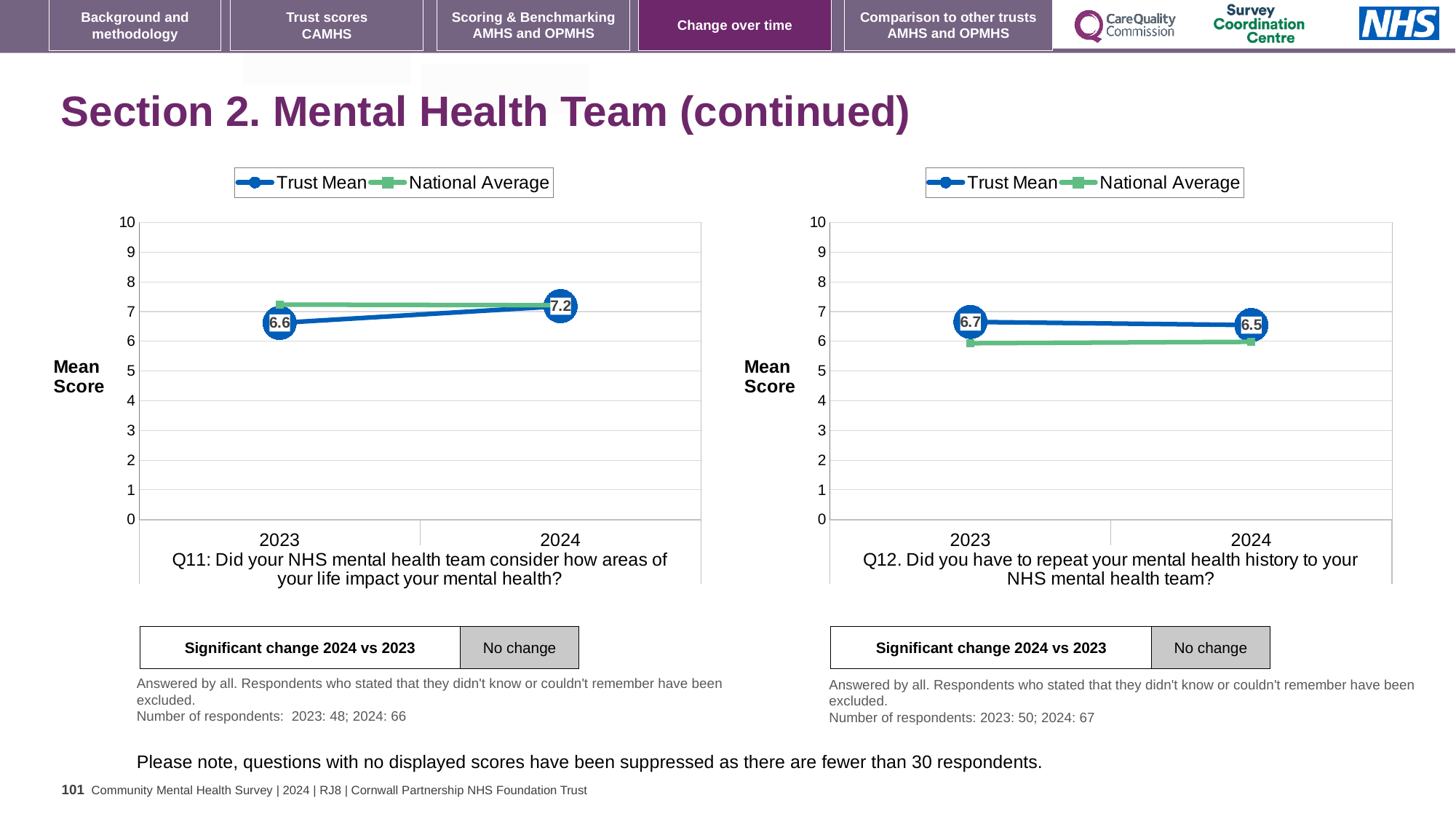
In the Q12 chart, which is larger in 2024, the Trust Mean or the National Average? Trust Mean In the Q11 chart, what is the Trust Mean score for 2023? 6.6 How many series does the legend of the Q11 chart list? 2 In the Q11 chart, what is the Trust Mean score for 2024? 7.2 In the Q11 chart, by how much did the Trust Mean change from 2023 to 2024? 0.6 In the Q12 chart, does the Trust Mean rise or fall from 2023 to 2024? fall In the Q12 chart, what is the difference between the Trust Mean for 2023 and 2024? 0.2 In the Q12 chart, is the National Average for 2023 greater or less than 7? less In the Q12 chart, what is the Trust Mean score for 2023? 6.7 In the Q11 chart, does the Trust Mean rise or fall from 2023 to 2024? rise What type of chart is used for Q12? line chart In the Q12 chart, what is the Trust Mean score for 2024? 6.5